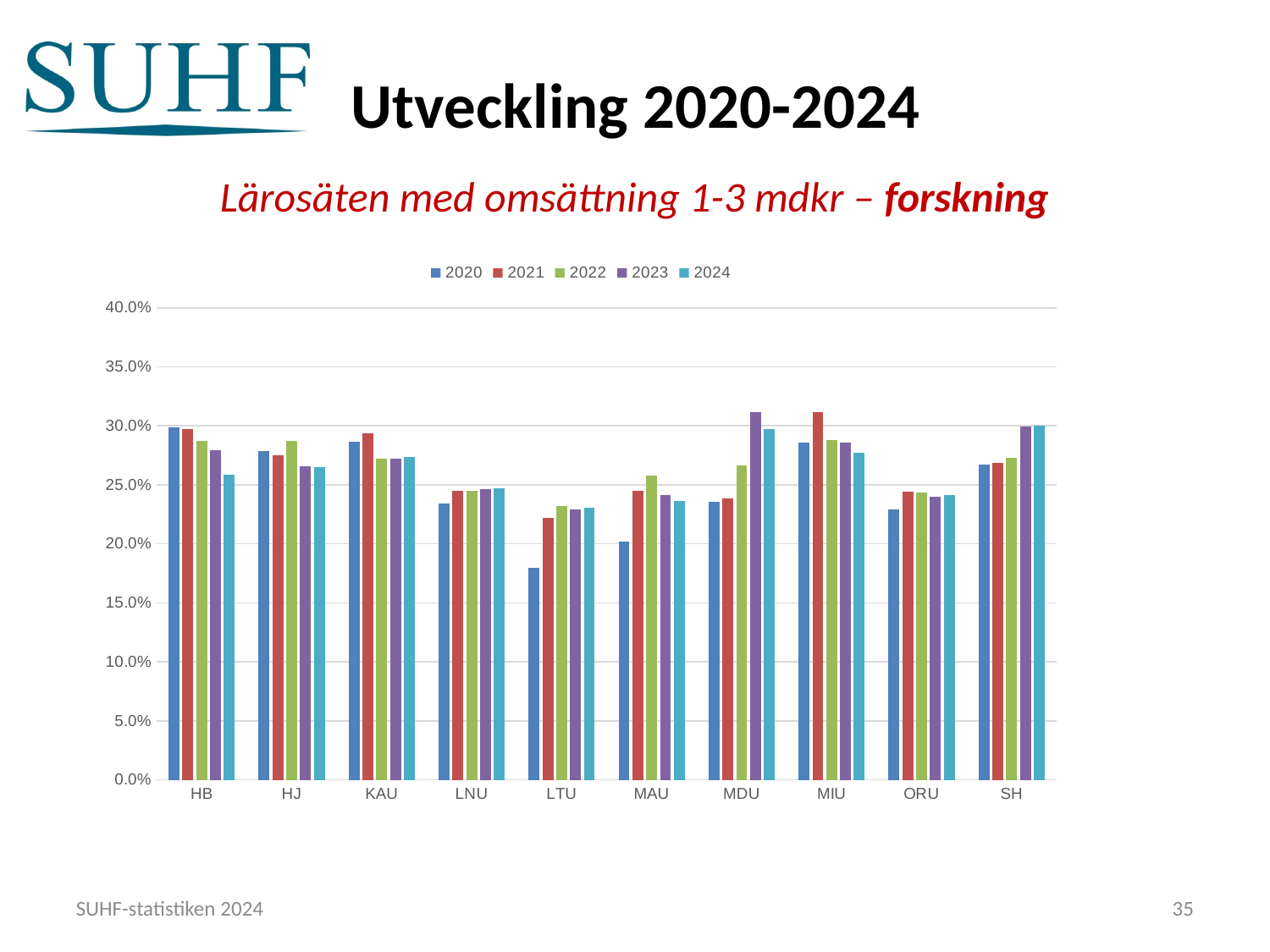
Is the 2020 value for LTU greater or less than 20.0%? less Is the 2021 value for MIU greater or less than 30.0%? greater Do the values for LTU rise or fall from 2020 to 2022? rise Which year is listed first in the legend? 2020 Is the 2020 value for LNU greater or less than 25.0%? less Which is larger, the 2020 value for LTU or the 2020 value for MAU? MAU How many institutions (categories) are shown on the x axis? 10 Which institution has the highest 2021 value? MIU Which institution has the lowest 2020 value? LTU What kind of chart is shown on the slide? bar chart How many series does the legend list? 5